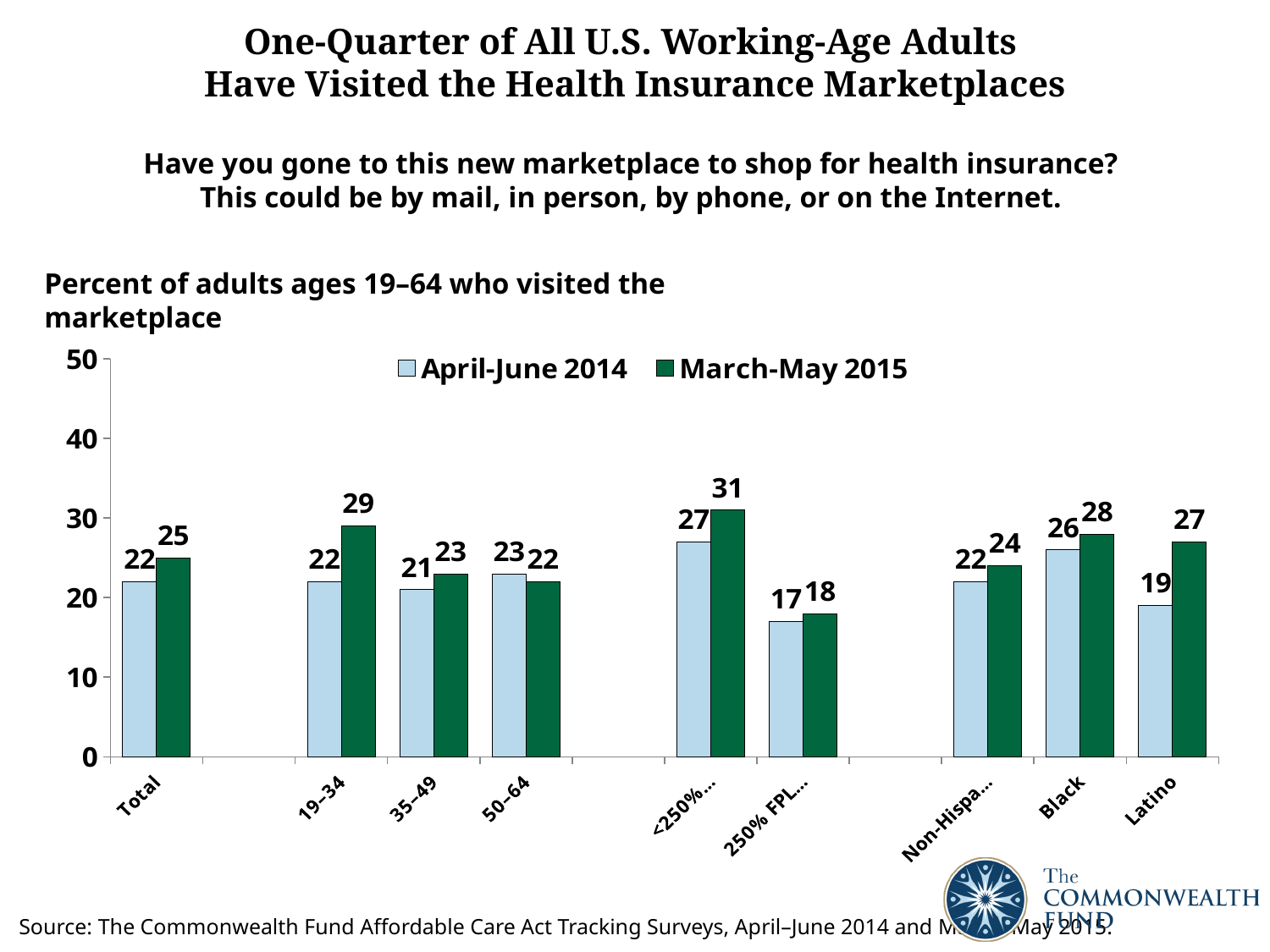
Which colour represents the March-May 2015 series? Dark green What is the April-June 2014 value for the 19–34 age group? 22 What kind of chart is shown on the slide? Bar chart What is the difference between the March-May 2015 and April-June 2014 values for Latino adults? 8 Which category has the highest March-May 2015 value among the age groups (19–34, 35–49, 50–64)? 19–34 What is the March-May 2015 value for Total? 25 What is the difference between the March-May 2015 and April-June 2014 values for the 19–34 age group? 7 What is the April-June 2014 value for Black adults? 26 What is the March-May 2015 value for Latino adults? 27 How many series does the legend list? 2 For the 50–64 age group, which is larger: the April-June 2014 value or the March-May 2015 value? April-June 2014 Which of the categories Total, Black, and Latino has the lowest April-June 2014 value? Latino